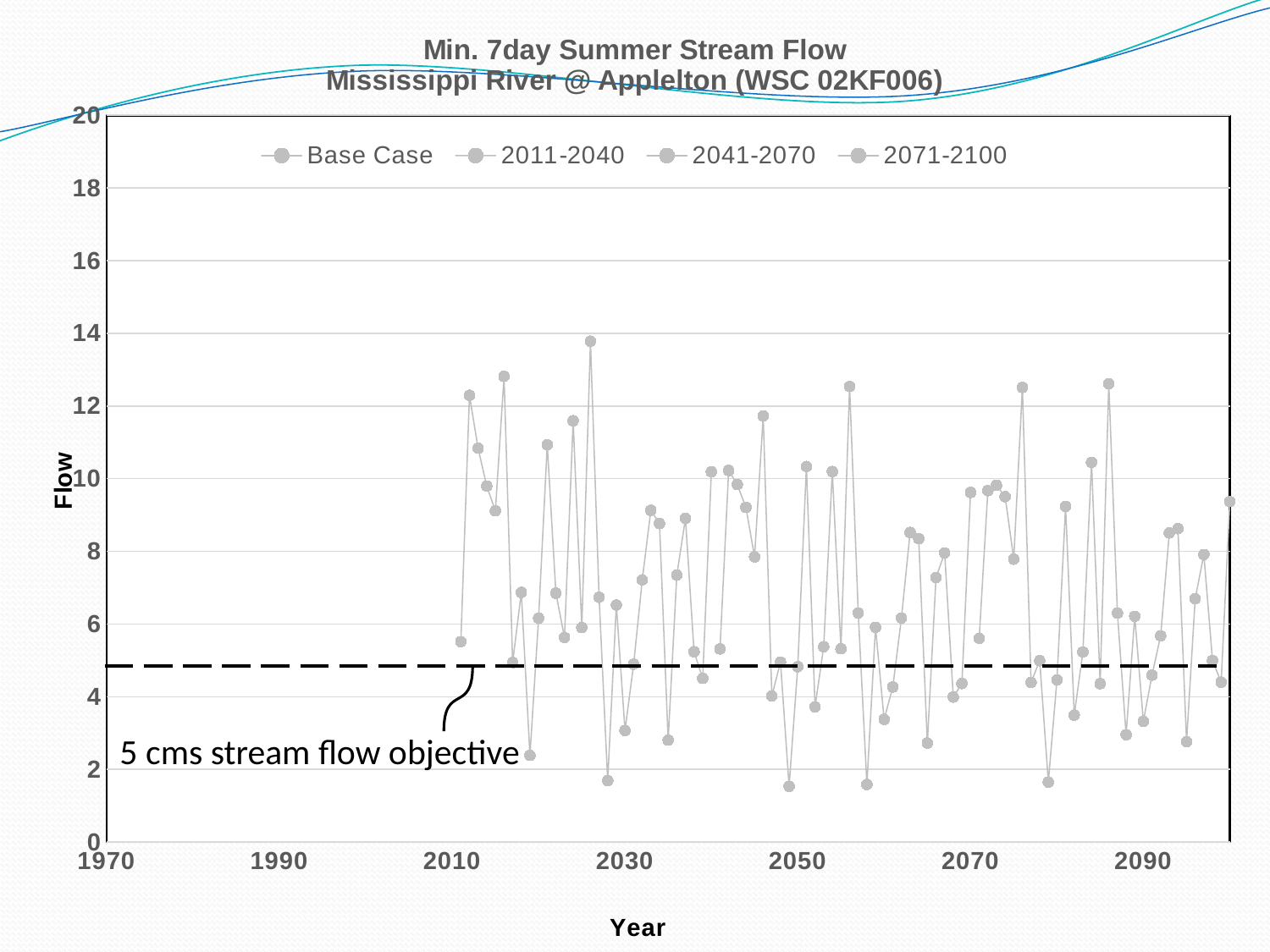
What is the label of the horizontal axis? Year Is the highest plotted flow value greater or less than 14? less What is the label of the vertical axis? Flow What is the first year shown on the Year axis? 1970 What is the title of the chart? Min. 7day Summer Stream Flow Mississippi River @ Applelton (WSC 02KF006) How many series does the legend list? 4 Is the highest plotted flow value greater or less than 12? greater Is the lowest plotted flow value greater or less than 2? less What kind of chart is shown on the slide? Line chart What value does the dashed horizontal line represent, according to the annotation? 5 cms stream flow objective What is the maximum value shown on the Flow axis? 20